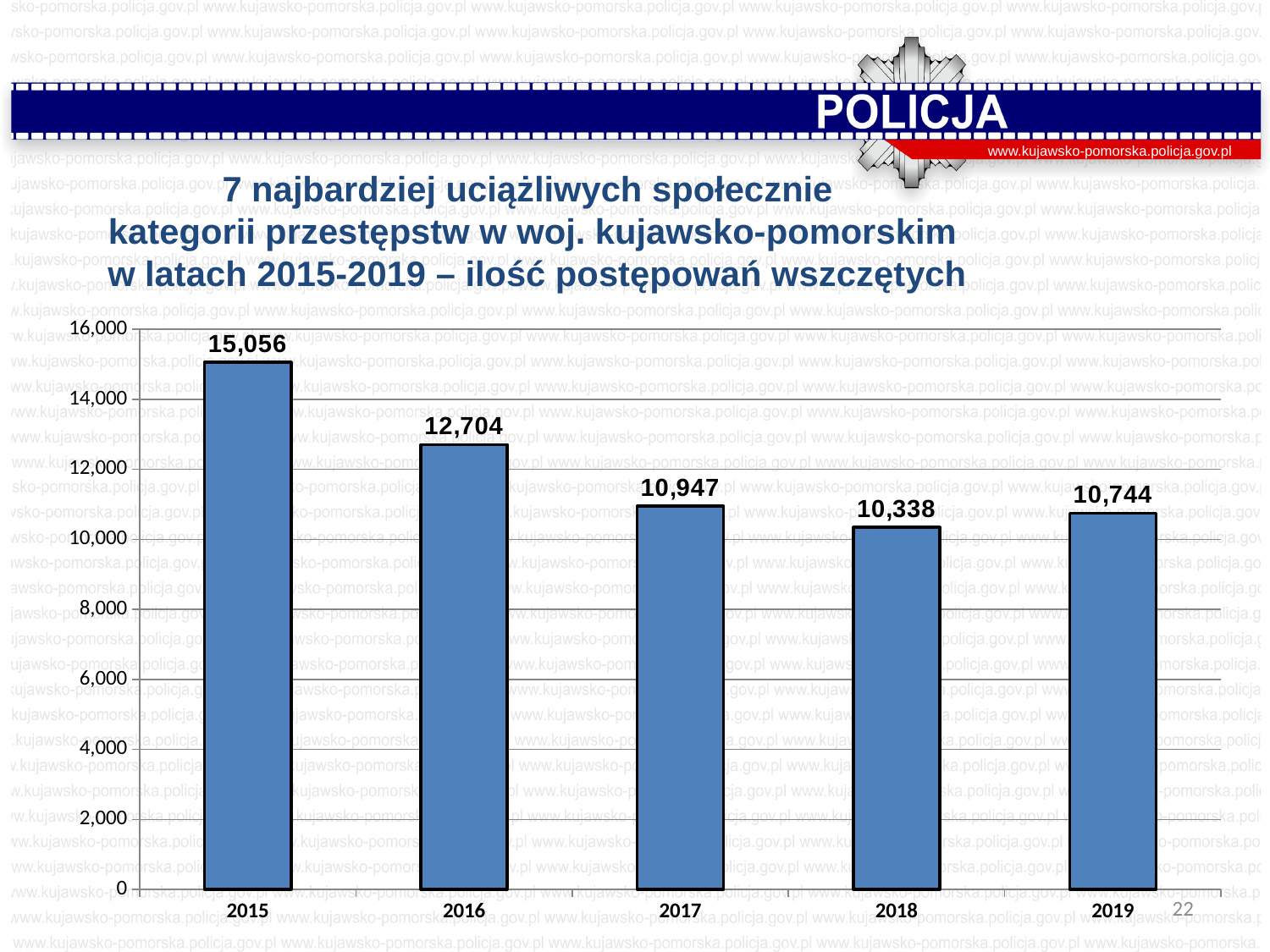
What is the difference between the values for 2015 and 2016? 2,352 Which year has the lowest value? 2018 How many years are shown on the x axis? 5 What is the value for 2015? 15,056 Which year has the highest value? 2015 Is the value for 2016 greater or less than 12,000? greater What kind of chart is shown on the slide? bar chart Do the values rise or fall from 2015 to 2018? fall What is the value for 2017? 10,947 Which is larger, the value for 2017 or the value for 2019? 2017 What is the value for 2019? 10,744 What is the difference between the values for 2019 and 2018? 406